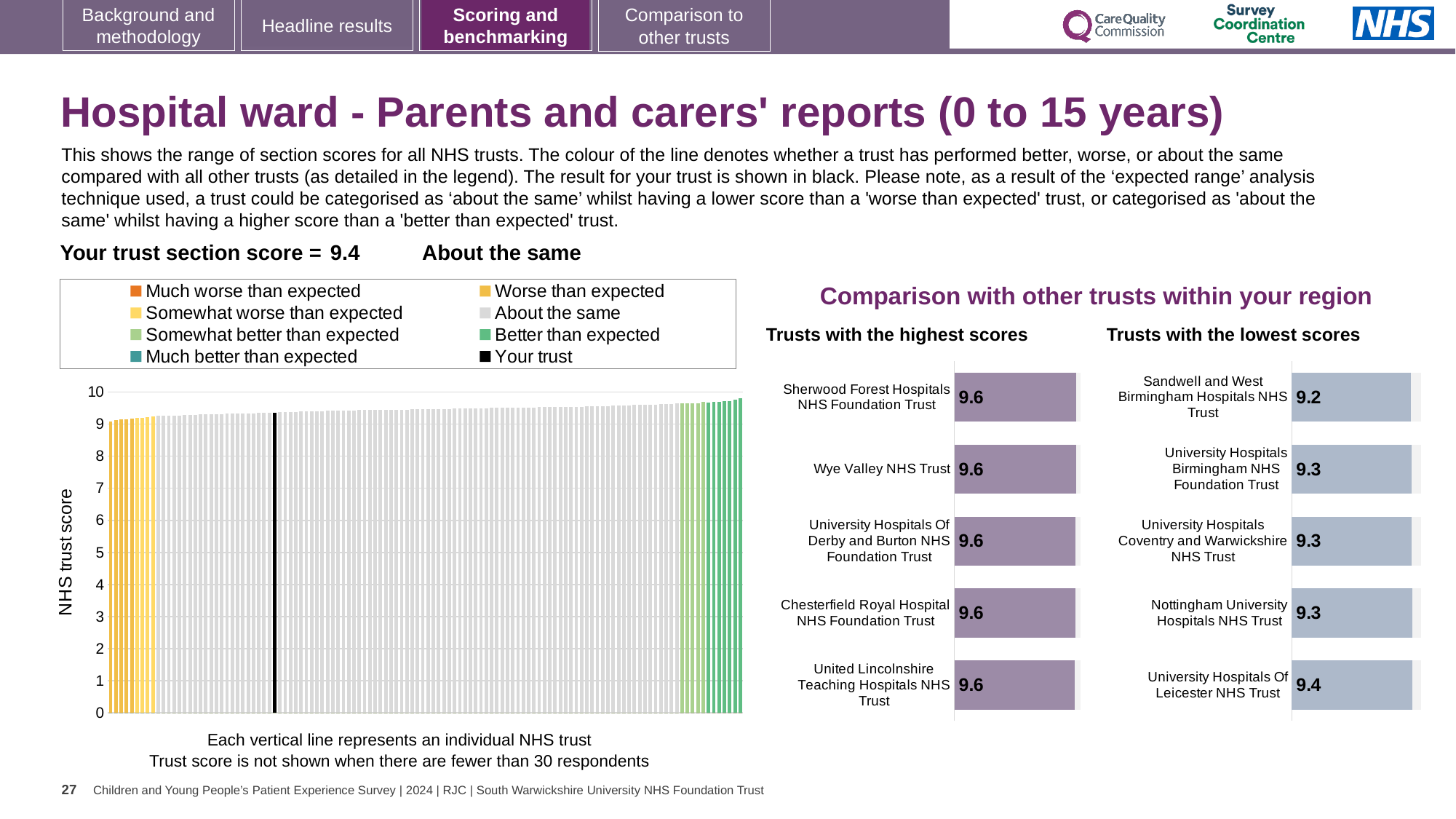
In the 'Trusts with the lowest scores' chart, what is the difference between the scores of University Hospitals Of Leicester NHS Trust and Sandwell and West Birmingham Hospitals NHS Trust? 0.2 In the main 'NHS trust score' chart, is the value for your trust (the black line) greater or less than 9? greater In the 'Trusts with the highest scores' chart, what is the score for Wye Valley NHS Trust? 9.6 In the 'Trusts with the lowest scores' chart, what is the score for University Hospitals Of Leicester NHS Trust? 9.4 In the 'Trusts with the lowest scores' chart, which trust has the highest score? University Hospitals Of Leicester NHS Trust In the 'Trusts with the lowest scores' chart, which trust has the lowest score? Sandwell and West Birmingham Hospitals NHS Trust What kind of chart is the main 'NHS trust score' chart? bar chart In the 'Trusts with the lowest scores' chart, what is the score for Sandwell and West Birmingham Hospitals NHS Trust? 9.2 How many trusts are listed in the 'Trusts with the highest scores' chart? 5 How many entries does the legend above the main 'NHS trust score' chart list? 8 In the 'Trusts with the lowest scores' chart, which has the larger score: Nottingham University Hospitals NHS Trust or Sandwell and West Birmingham Hospitals NHS Trust? Nottingham University Hospitals NHS Trust What is the section score for your trust shown on the slide? 9.4